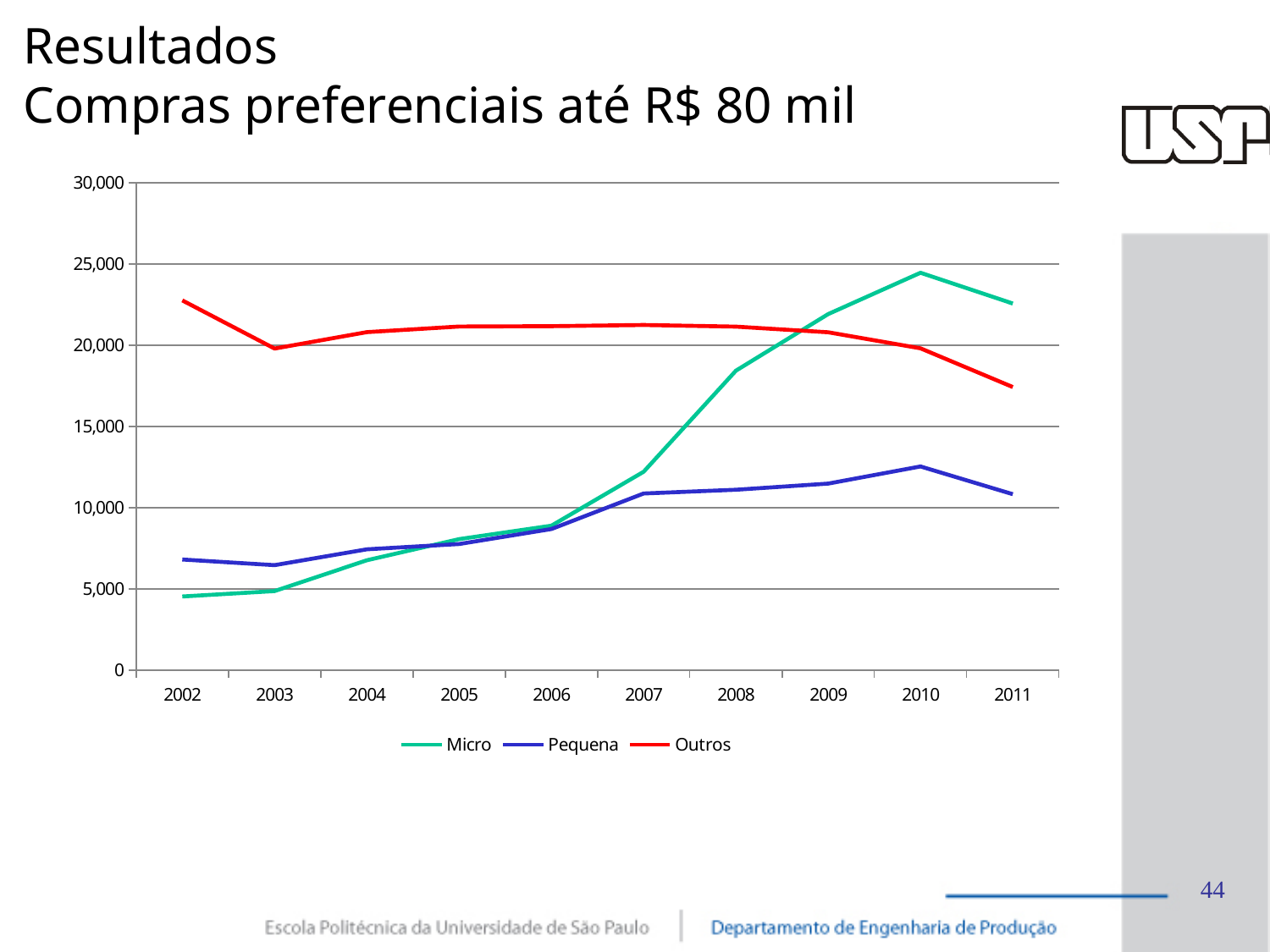
Is the value for Pequena in 2010 greater or less than 10,000? greater How many years are shown on the x axis? 10 How many series does the legend list? 3 In which year does the Micro series reach its highest value? 2010 Is the value for Outros in 2011 greater or less than 20,000? less In which year is the Outros series at its lowest? 2011 Is the value for Micro in 2002 greater or less than 5,000? less Does the Micro series rise or fall from 2002 to 2010? Rise Which series has the lowest value in 2002? Micro What kind of chart is shown on the slide? Line chart Which is larger in 2002, the value for Outros or the value for Micro? Outros Which series has the highest value in 2011? Micro